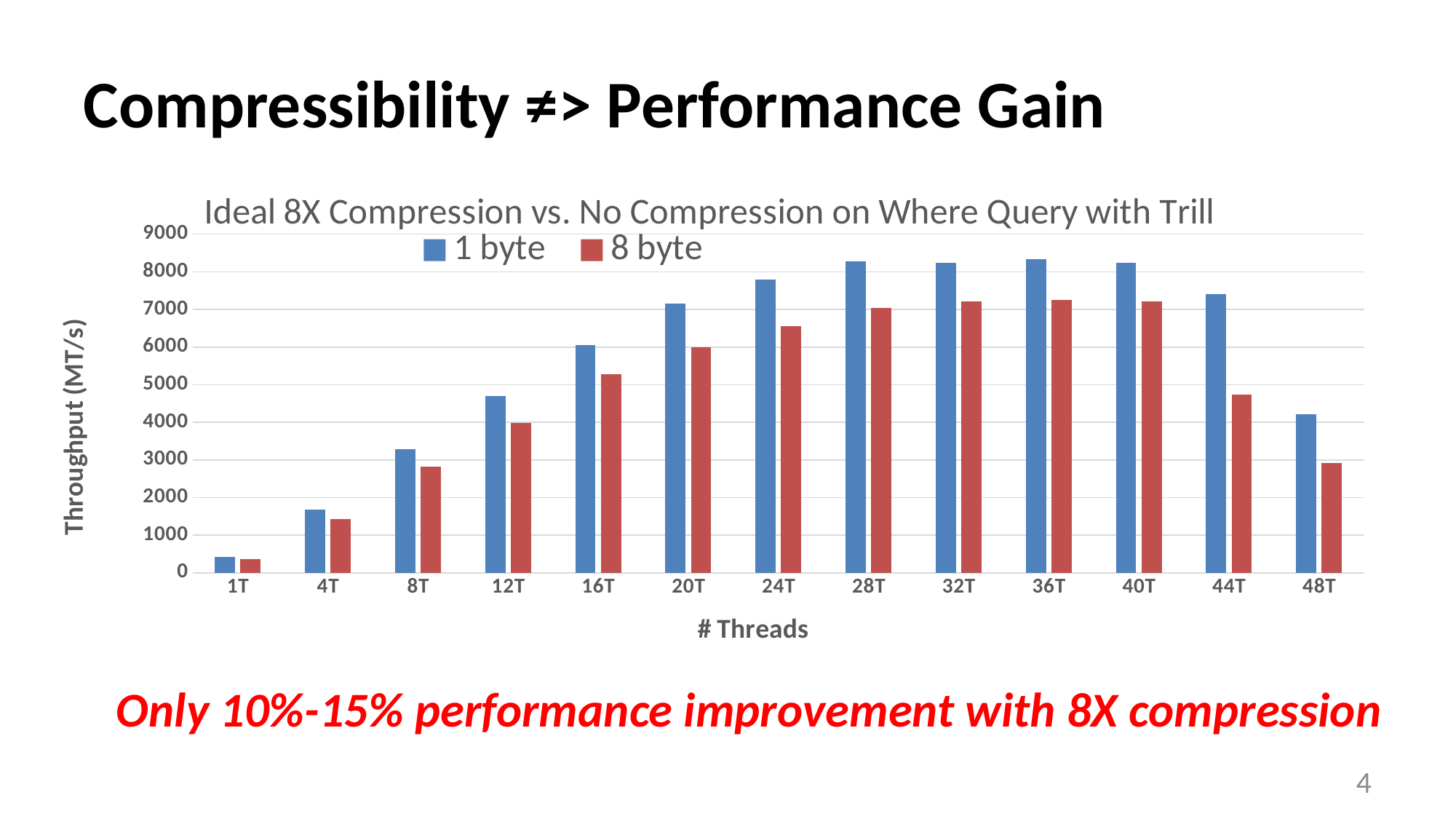
Which thread count has the lowest throughput for the 1 byte series? 1T At 16T, which series has the higher throughput, 1 byte or 8 byte? 1 byte How many thread-count categories are shown on the x axis? 13 Is the 8 byte throughput at 44T greater or less than 4000? greater Is the 1 byte throughput at 24T greater or less than 7000? greater Is the 1 byte throughput at 8T greater or less than 3000? greater Does the 1 byte throughput rise or fall from 1T to 24T? rise How many series does the legend list? 2 What is the title of the chart? Ideal 8X Compression vs. No Compression on Where Query with Trill What kind of chart is shown on the slide? bar chart Which thread count has the lowest throughput for the 8 byte series? 1T